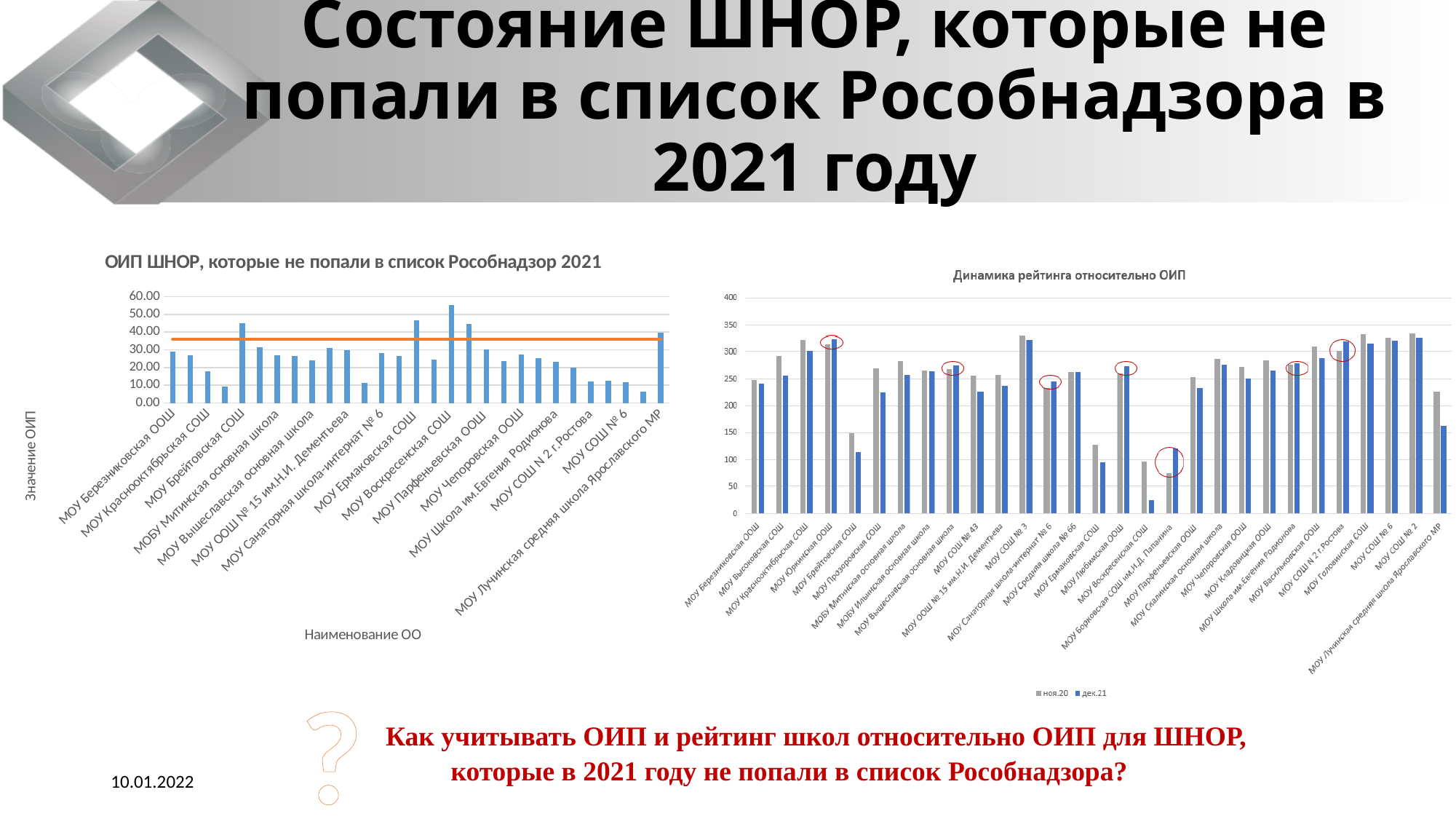
In the left chart 'ОИП ШНОР, которые не попали в список Рособнадзор 2021', is the value for МОУ Воскресенская СОШ greater or less than 50.00? greater In the left chart 'ОИП ШНОР, которые не попали в список Рособнадзор 2021', is the value for МОУ Санаторная школа-интернат № 6 greater or less than 20.00? greater What is the x-axis title of the left chart 'ОИП ШНОР, которые не попали в список Рособнадзор 2021'? Наименование ОО In the right chart 'Динамика рейтинга относительно ОИП', is the дек.21 value for МОУ Брейтовская СОШ greater or less than 150? less In the left chart 'ОИП ШНОР, которые не попали в список Рособнадзор 2021', which is larger: the value for МОУ Брейтовская СОШ or for МОУ Санаторная школа-интернат № 6? МОУ Брейтовская СОШ In the left chart 'ОИП ШНОР, которые не попали в список Рособнадзор 2021', which of the labelled schools has the highest bar? МОУ Воскресенская СОШ What kind of chart is the left chart titled 'ОИП ШНОР, которые не попали в список Рособнадзор 2021'? combination bar and line chart What are the legend entries of the right chart 'Динамика рейтинга относительно ОИП'? ноя.20 and дек.21 How many series does the legend of the right chart 'Динамика рейтинга относительно ОИП' list? 2 In the right chart 'Динамика рейтинга относительно ОИП', which is larger for МОУ Лучинская средняя школа Ярославского МР: the ноя.20 value or the дек.21 value? ноя.20